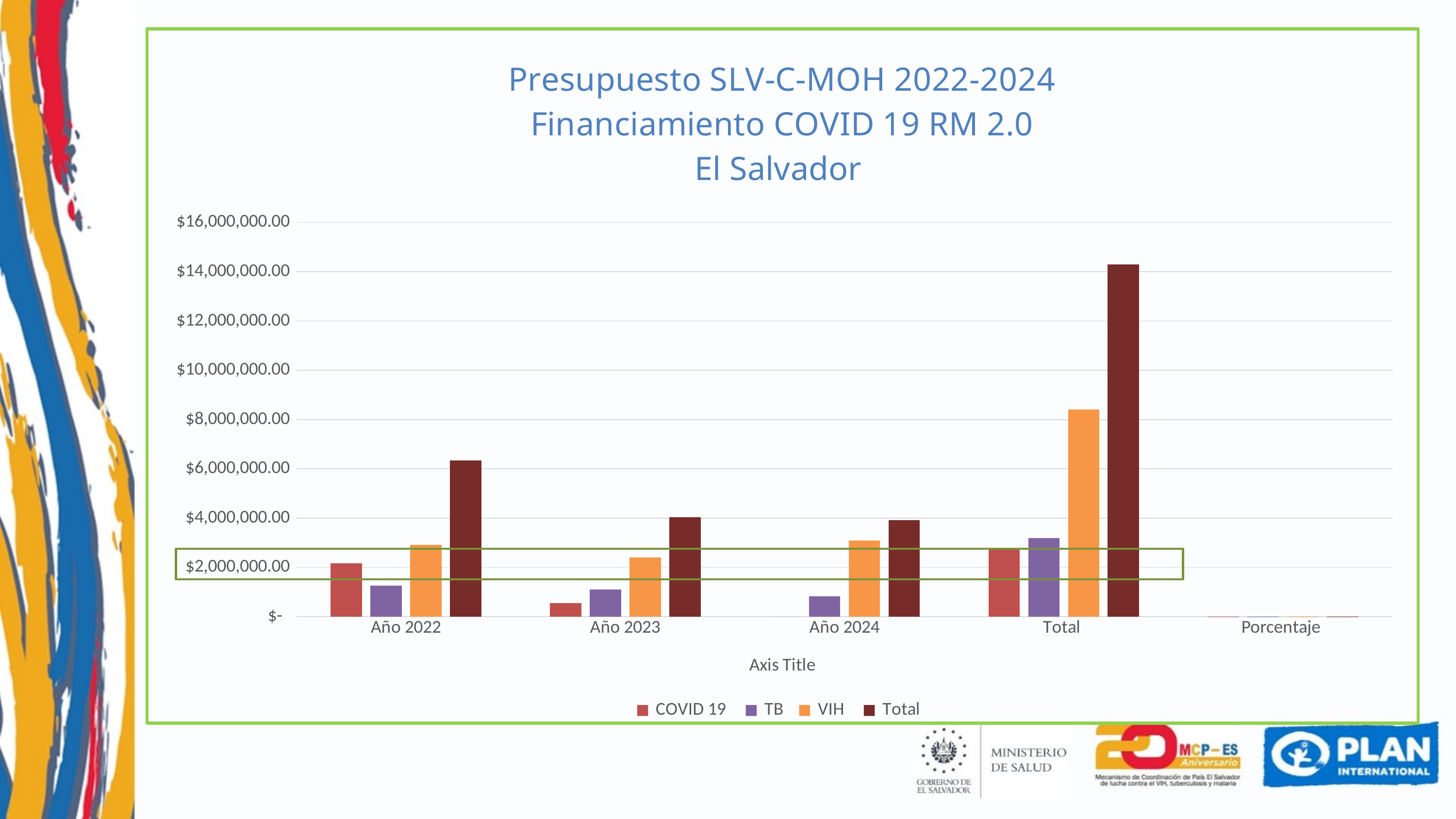
Which is larger in Año 2024, the VIH bar or the TB bar? VIH What kind of chart is shown on the slide? bar chart Is the value of the COVID 19 series in Año 2023 greater or less than $2,000,000.00? less In which category is the Total series bar the highest? Total Is the value of the Total series in the Total category greater or less than $12,000,000.00? greater Is the value of the VIH series in the Total category greater or less than $6,000,000.00? greater Which series has the tallest bar in the Año 2022 category? Total How many categories are shown along the x axis? 5 How many series does the legend list? 4 What is the x-axis title shown on the chart? Axis Title Does the Total series rise or fall from Año 2022 to Año 2024? fall Which series has the shortest bar in the Año 2023 category? COVID 19